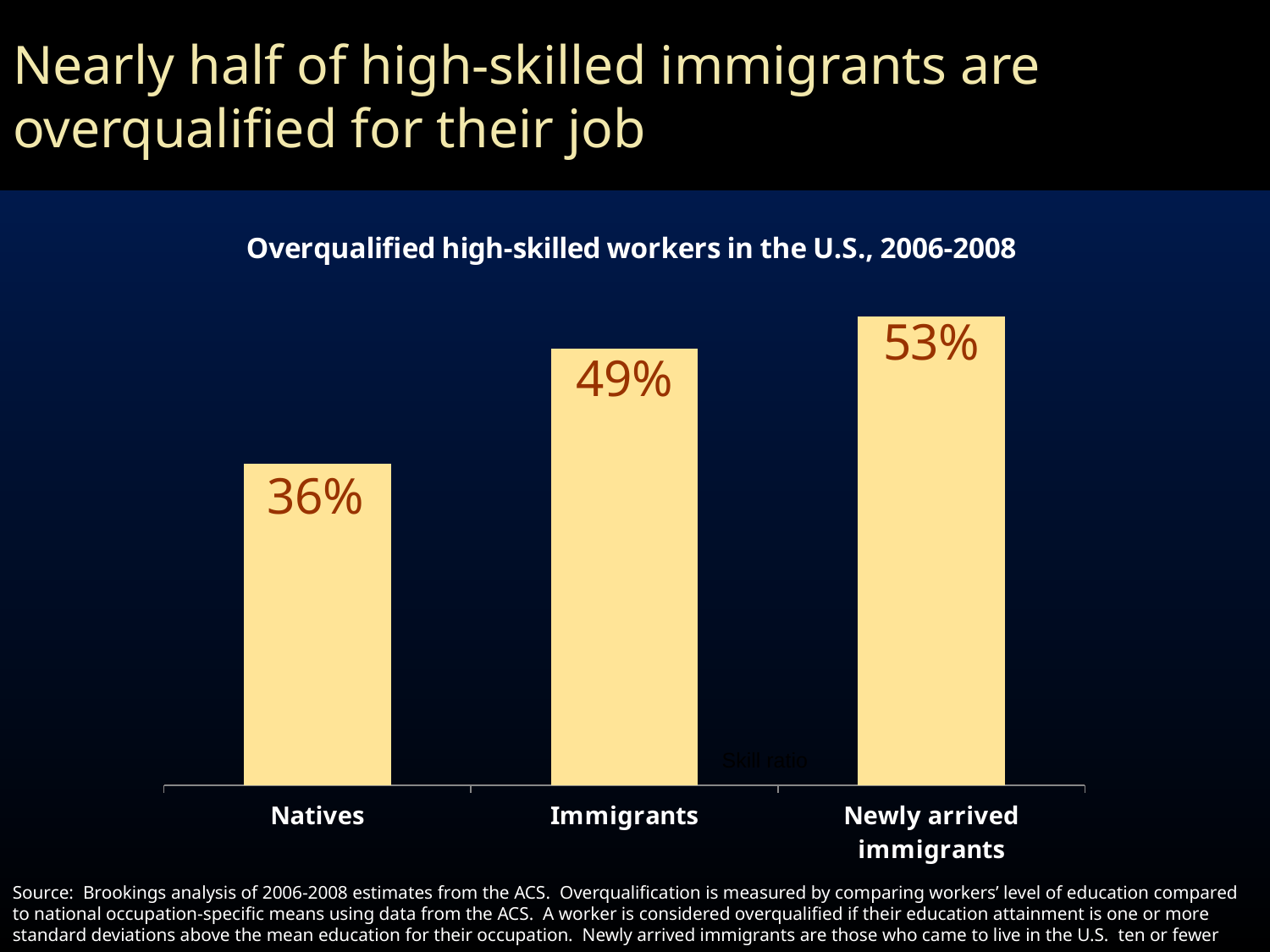
What is the value for Newly arrived immigrants? 53% Which category has the highest value? Newly arrived immigrants Which is larger, the value for Immigrants or the value for Natives? Immigrants Do the values rise or fall from left to right across the categories? Rise What is the difference between the values for Newly arrived immigrants and Natives? 17% What is the value for Natives? 36% What is the difference between the values for Immigrants and Natives? 13% Which category has the lowest value? Natives What kind of chart is this? Bar chart What is the title of the chart? Overqualified high-skilled workers in the U.S., 2006-2008 How many categories are shown in the chart? 3 What is the value for Immigrants? 49%